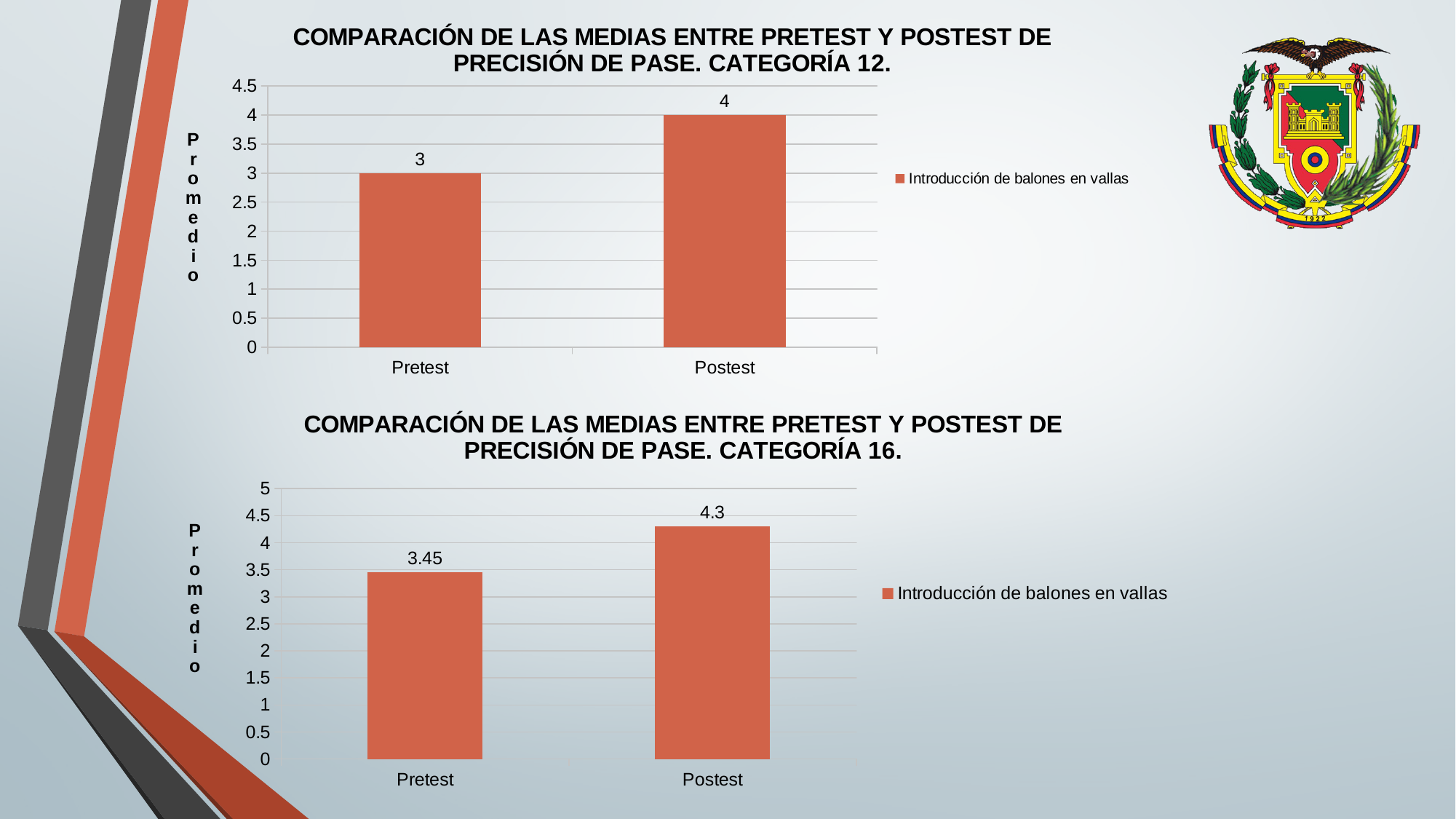
In the Categoría 16 chart (bottom), which category has the lower value? Pretest In the Categoría 16 chart (bottom), what is the difference between the Postest and Pretest values? 0.85 What series name does the legend of the Categoría 12 chart (top) show? Introducción de balones en vallas In the Categoría 16 chart (bottom), is the value for Pretest greater or less than 3? greater How many categories are shown on the x axis of the Categoría 12 chart (top)? 2 In the Categoría 12 chart (top), what is the value for Postest? 4 In the Categoría 16 chart (bottom), what is the value for Postest? 4.3 In the Categoría 12 chart (top), what is the difference between the Postest and Pretest values? 1 What kind of chart is the Categoría 16 chart (bottom)? Bar chart In the Categoría 12 chart (top), what is the value for Pretest? 3 In the Categoría 12 chart (top), which category has the higher value? Postest In the Categoría 16 chart (bottom), what is the value for Pretest? 3.45